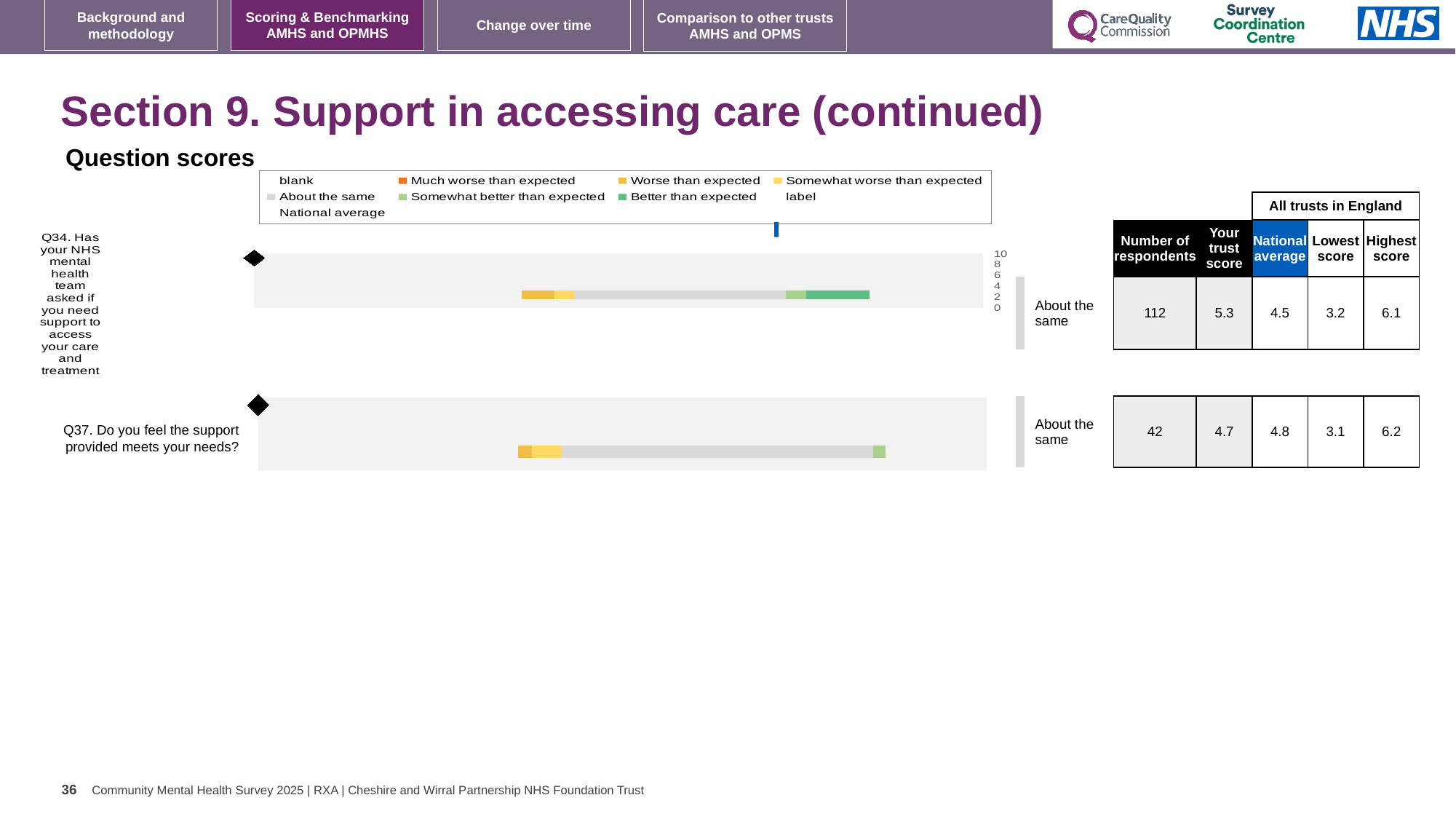
What is the trust score for Q34 (Has your NHS mental health team asked if you need support to access your care and treatment)? 5.3 What is the difference between the national average and the trust score for Q37? 0.1 Which question has the higher trust score, Q34 or Q37? Q34 How many respondents answered Q37? 42 What is the national average for Q37 (Do you feel the support provided meets your needs)? 4.8 What kind of chart is used to show the question scores? bar chart What benchmark category is shown for Q34? About the same Which legend entry is shown in grey? About the same Is the trust score for Q37 greater or less than 4? greater What is the title of the chart? Question scores How many questions are plotted in the Question scores chart? 2 What is the difference between the highest score and the lowest score for Q34? 2.9